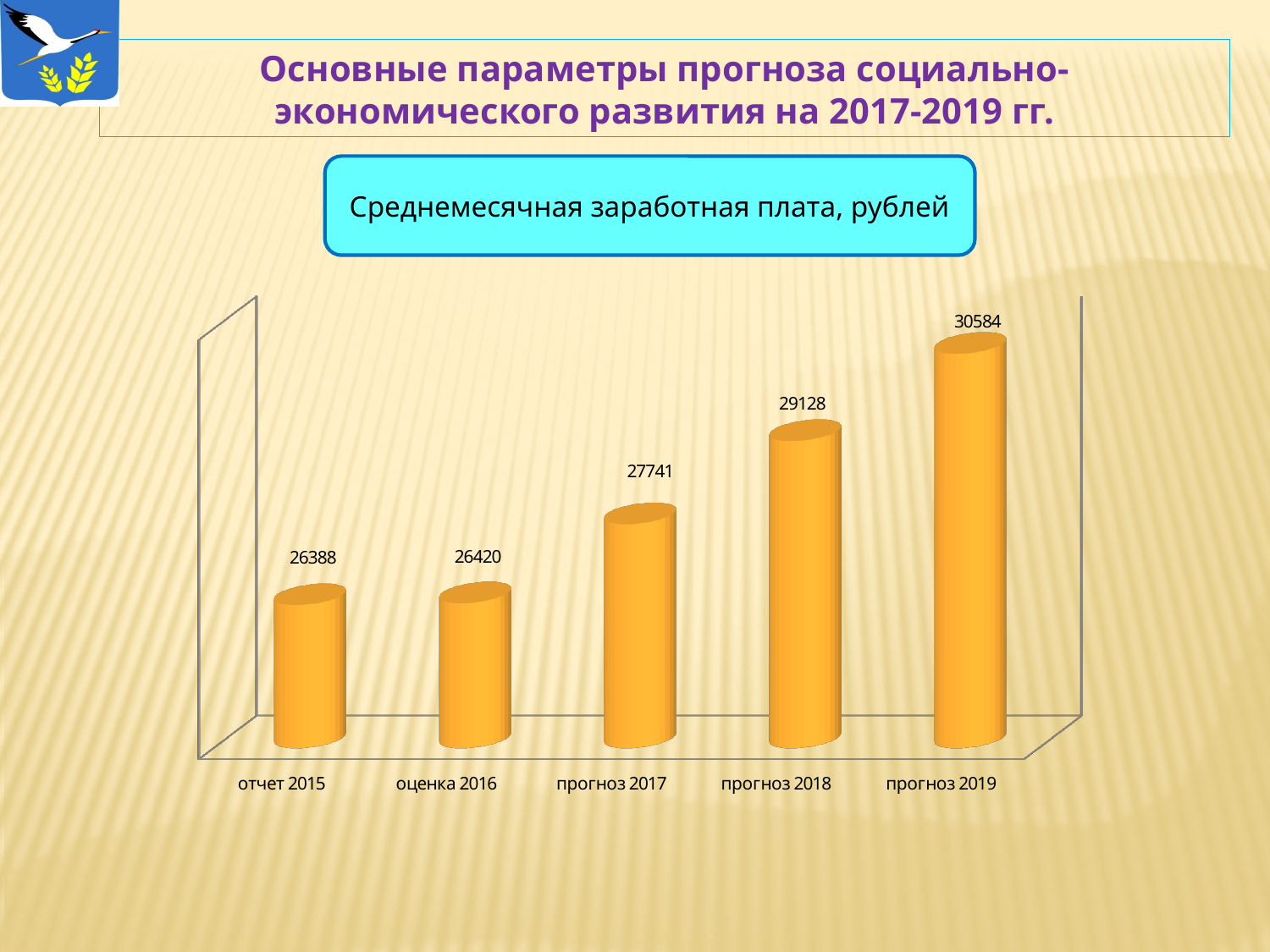
What kind of chart is shown on the slide? bar chart What is the difference between the values for прогноз 2019 and прогноз 2018? 1456 What is the value for отчет 2015? 26388 Which is larger, the value for прогноз 2018 or the value for прогноз 2017? прогноз 2018 Which category has the highest value? прогноз 2019 What is the value for прогноз 2017? 27741 Which category has the lowest value? отчет 2015 What is the title shown above the chart? Среднемесячная заработная плата, рублей What is the value for прогноз 2019? 30584 Do the values rise or fall from отчет 2015 to прогноз 2019? rise What is the difference between the values for прогноз 2017 and оценка 2016? 1321 How many categories are shown on the x axis? 5